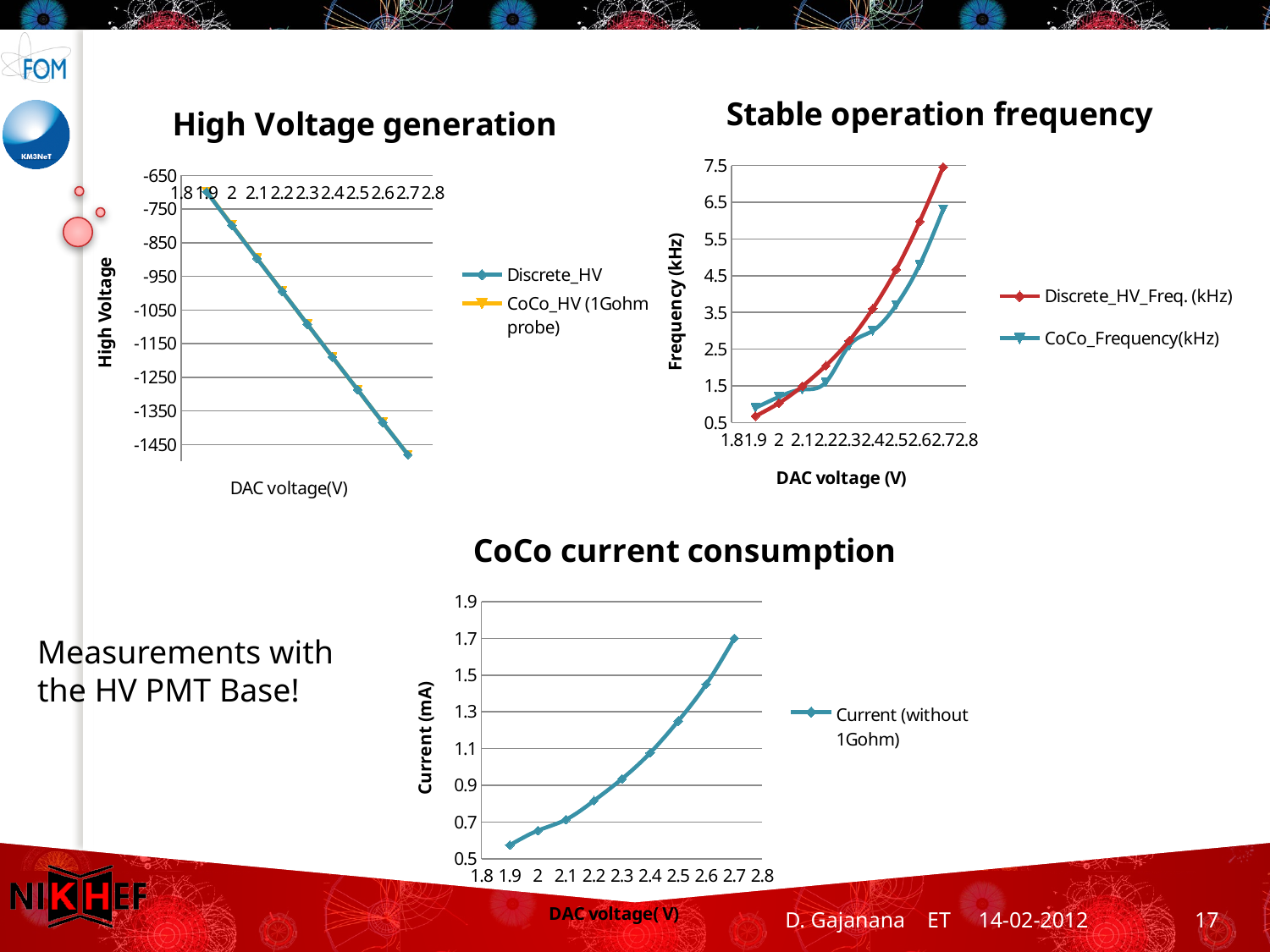
What is the y-axis title of the 'CoCo current consumption' chart? Current (mA) What kind of chart is the 'CoCo current consumption' chart? line chart In the 'Stable operation frequency' chart, is the Discrete_HV_Freq. (kHz) value at DAC voltage 2.7 greater or less than 6.5? greater In the 'CoCo current consumption' chart, is the current at DAC voltage 1.9 greater or less than 0.7? less In the 'CoCo current consumption' chart, does the current rise or fall as DAC voltage increases? rise How many series does the legend of the 'CoCo current consumption' chart list? 1 How many series does the legend of the 'High Voltage generation' chart list? 2 In the 'Stable operation frequency' chart, does the Discrete_HV_Freq. (kHz) series rise or fall as DAC voltage increases? rise In the 'Stable operation frequency' chart, which series has the higher value at DAC voltage 2.7, Discrete_HV_Freq. (kHz) or CoCo_Frequency(kHz)? Discrete_HV_Freq. (kHz) In the 'High Voltage generation' chart, do the High Voltage values rise or fall as DAC voltage increases? fall In the 'CoCo current consumption' chart, is the current at DAC voltage 2.7 greater or less than 1.5? greater How many series does the legend of the 'Stable operation frequency' chart list? 2